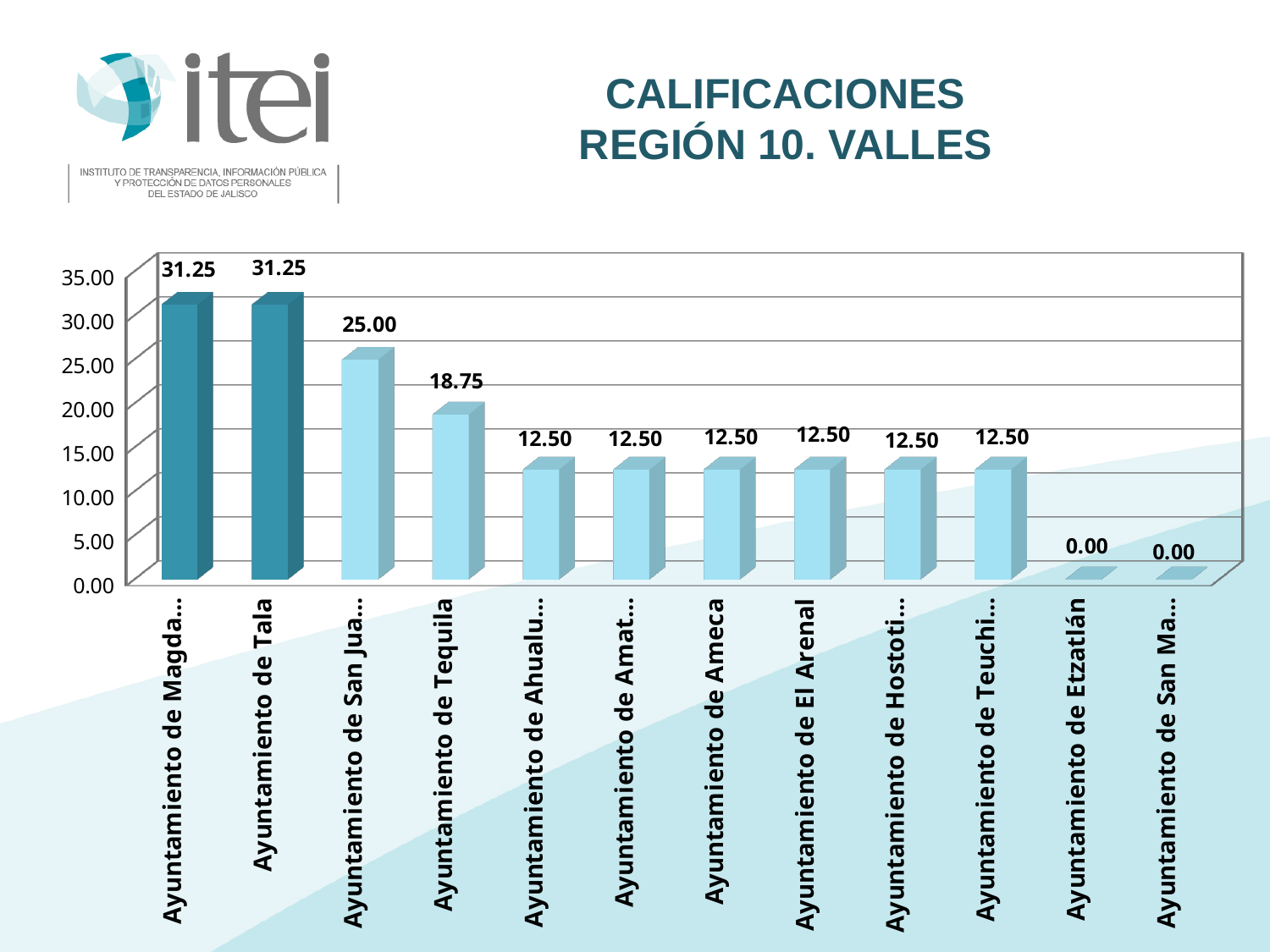
Which has a larger value, Ayuntamiento de Tequila or Ayuntamiento de Ameca? Ayuntamiento de Tequila What is the value for Ayuntamiento de Etzatlán? 0.00 What kind of chart is shown on the slide? Bar chart What is the value for Ayuntamiento de Tequila? 18.75 What is the value for Ayuntamiento de Ameca? 12.50 What is the difference between the values for Ayuntamiento de Tala and Ayuntamiento de Tequila? 12.50 Do the values rise or fall from left to right along the x axis? Fall How many categories (bars) are shown in the chart? 12 What is the title of the slide? CALIFICACIONES REGIÓN 10. VALLES What is the value for Ayuntamiento de Tala? 31.25 What is the difference between the values for Ayuntamiento de Tala and Ayuntamiento de Ameca? 18.75 What is the value for Ayuntamiento de El Arenal? 12.50